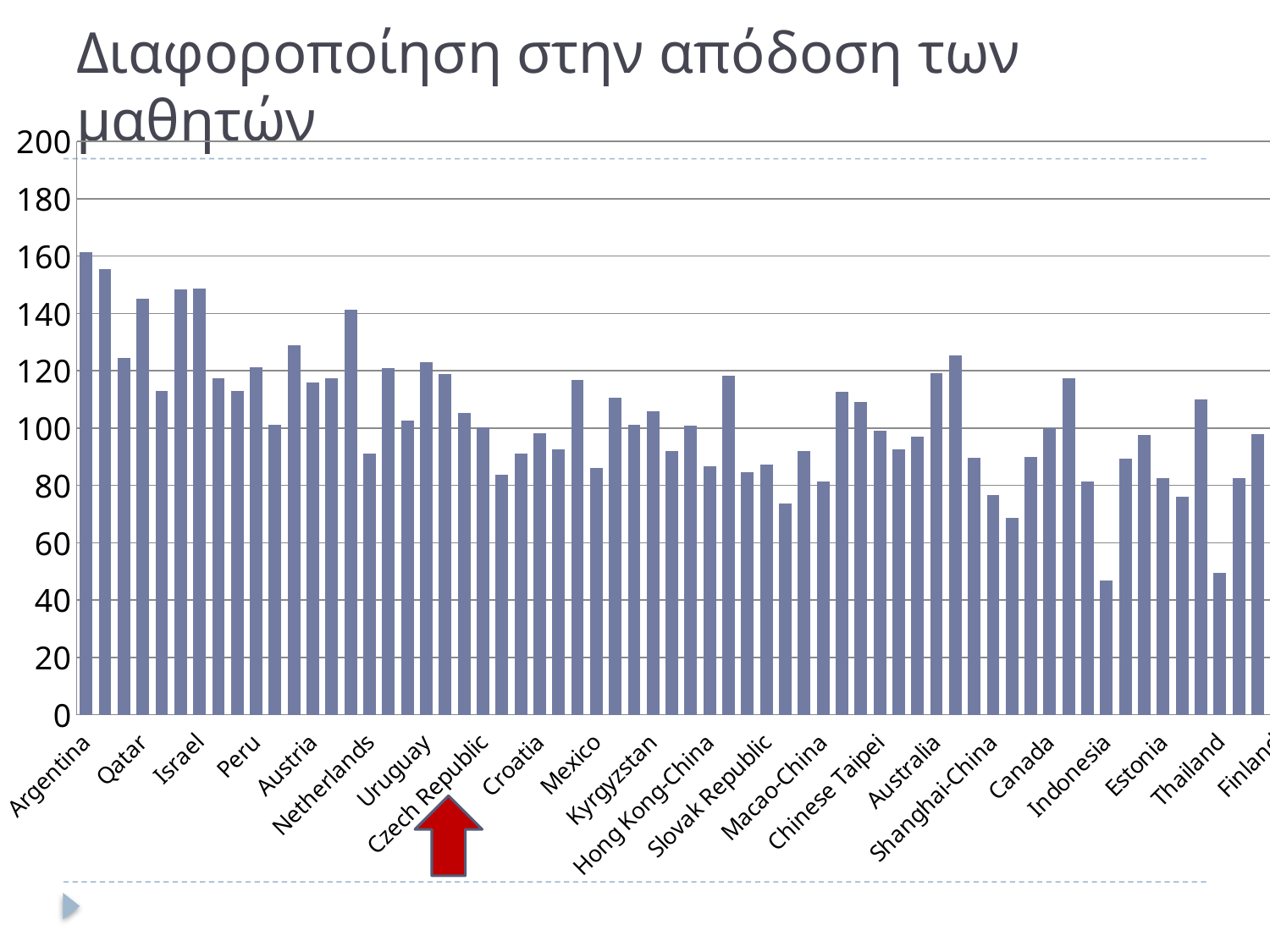
Is the value for Indonesia greater or less than 60? less Is the value for Uruguay greater or less than 100? greater Is the value for Mexico greater or less than 100? less Which country does the red arrow below the chart point to? Czech Republic Which has the larger value, Australia or Macao-China? Australia What kind of chart is shown on the slide? bar chart Do the values generally rise or fall from left to right across the chart? fall Which country has the highest value in the chart? Argentina Which has the larger value, Argentina or Czech Republic? Argentina